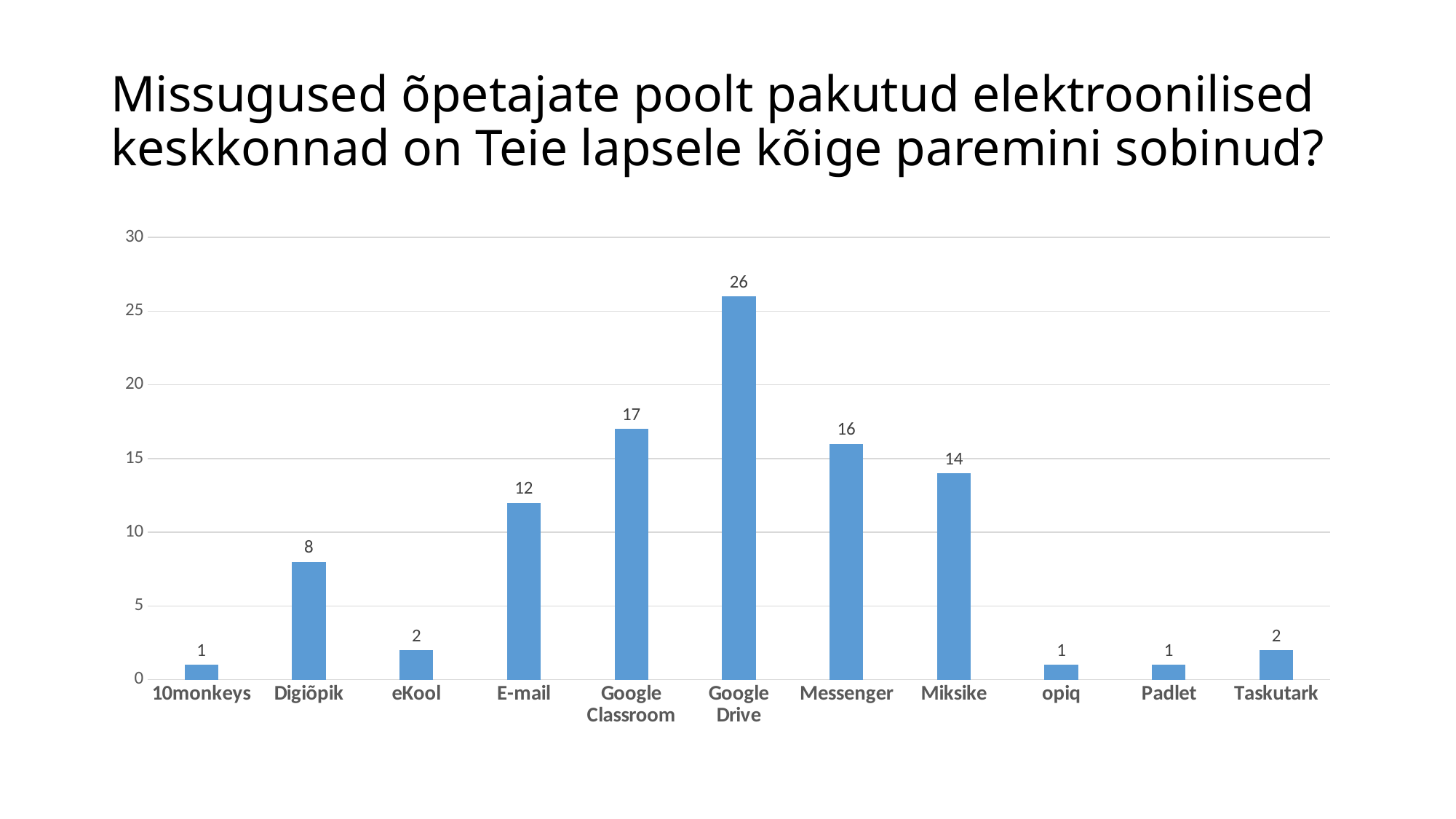
What is the value for Taskutark? 2 What is the highest value shown on the y axis? 30 How many categories are shown on the x axis? 11 Which category has the highest value? Google Drive What kind of chart is shown on the slide? bar chart Which is larger, the value for Messenger or the value for Miksike? Messenger What is the value for Messenger? 16 What is the difference between the values for E-mail and Miksike? 2 What is the difference between the values for Google Drive and Google Classroom? 9 Is the value for Google Classroom greater or less than 15? greater What is the value for Digiõpik? 8 What is the value for Google Drive? 26